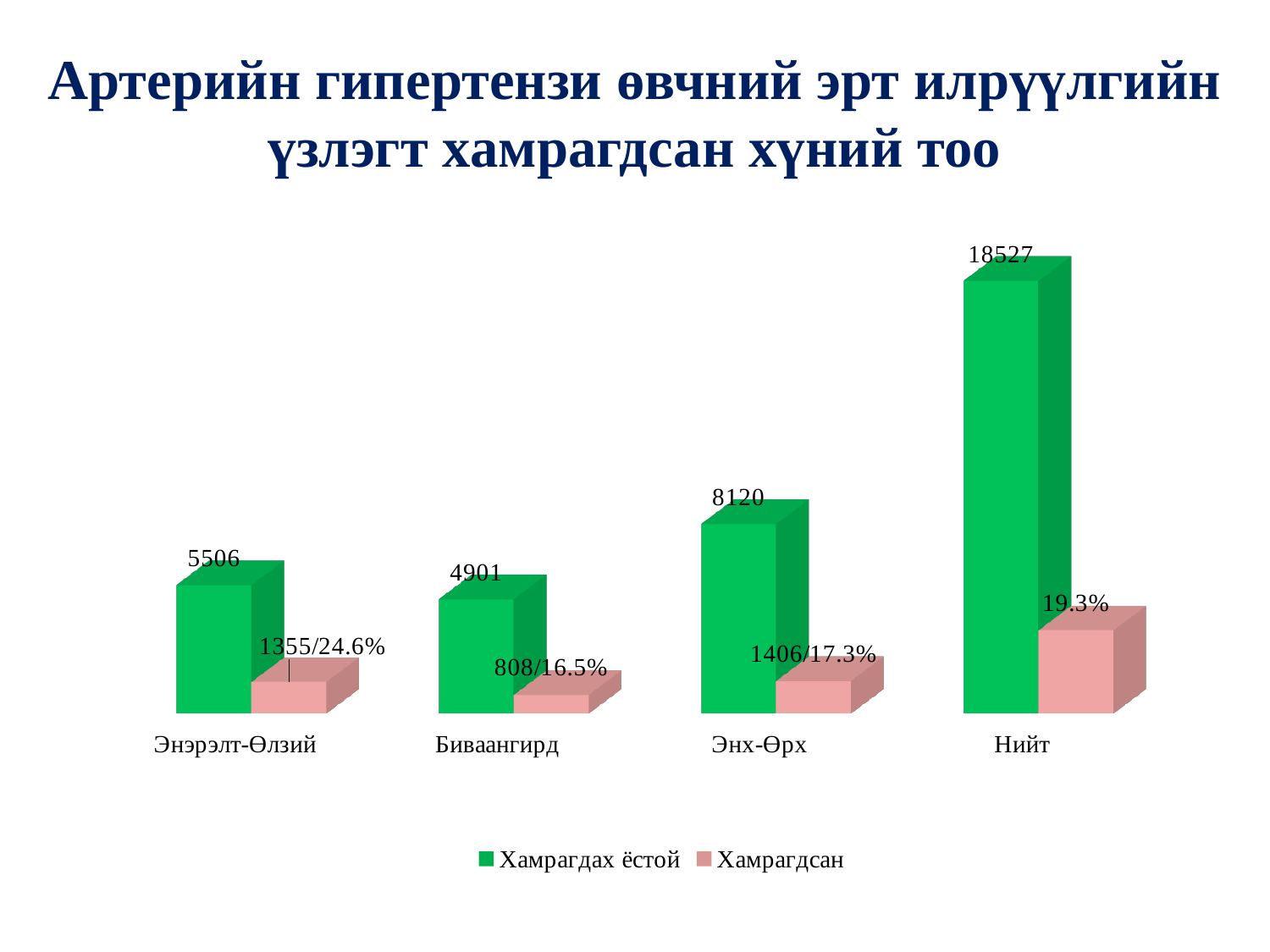
How many categories are shown on the x axis? 4 Which is larger, the Хамрагдах ёстой value for Энэрэлт-Өлзий or for Биваангирд? Энэрэлт-Өлзий How many series does the legend list? 2 What data label is shown on the Хамрагдсан bar for Энэрэлт-Өлзий? 1355/24.6% What is the difference between the Хамрагдах ёстой values for Энх-Өрх and Энэрэлт-Өлзий? 2614 What data label is shown on the Хамрагдсан bar for Биваангирд? 808/16.5% What is the value of Хамрагдах ёстой for Энх-Өрх? 8120 What kind of chart is shown on the slide? Bar chart What data label is shown on the Хамрагдсан bar for Нийт? 19.3% Which category has the highest Хамрагдах ёстой value? Нийт Which category has the lowest Хамрагдах ёстой value? Биваангирд What is the value of Хамрагдах ёстой for Нийт? 18527